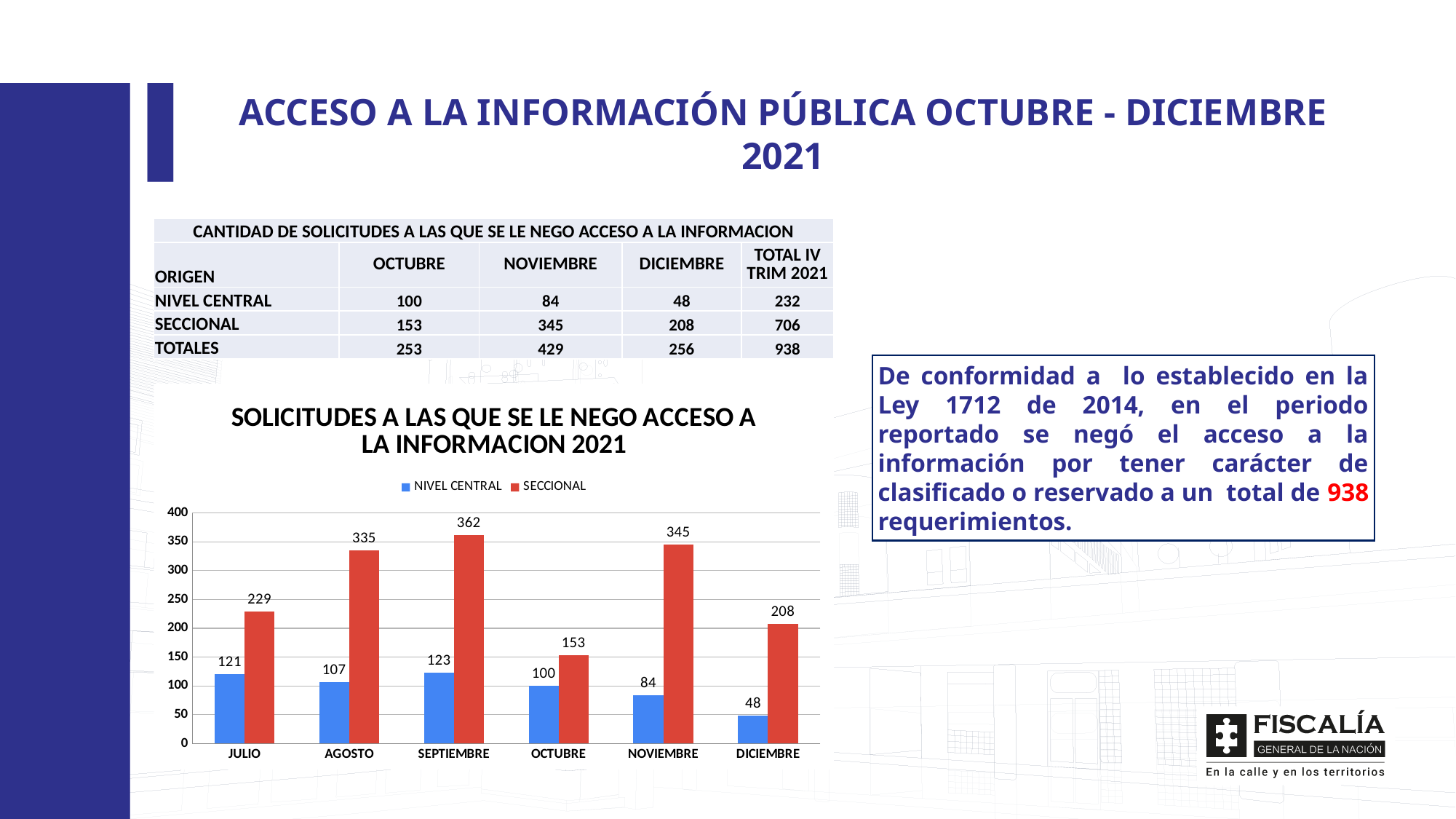
What is the difference between the SECCIONAL and NIVEL CENTRAL values in AGOSTO? 228 Which is larger in OCTUBRE, NIVEL CENTRAL or SECCIONAL? SECCIONAL Is the SECCIONAL value for JULIO greater or less than 200? greater Which month has the highest SECCIONAL value? SEPTIEMBRE What is the value for SECCIONAL in NOVIEMBRE? 345 What kind of chart is shown? bar chart How many series does the legend list? 2 What is the value for NIVEL CENTRAL in DICIEMBRE? 48 Which colour represents SECCIONAL in the chart? red What is the value for NIVEL CENTRAL in SEPTIEMBRE? 123 How many months are shown on the x axis? 6 Which month has the lowest NIVEL CENTRAL value? DICIEMBRE